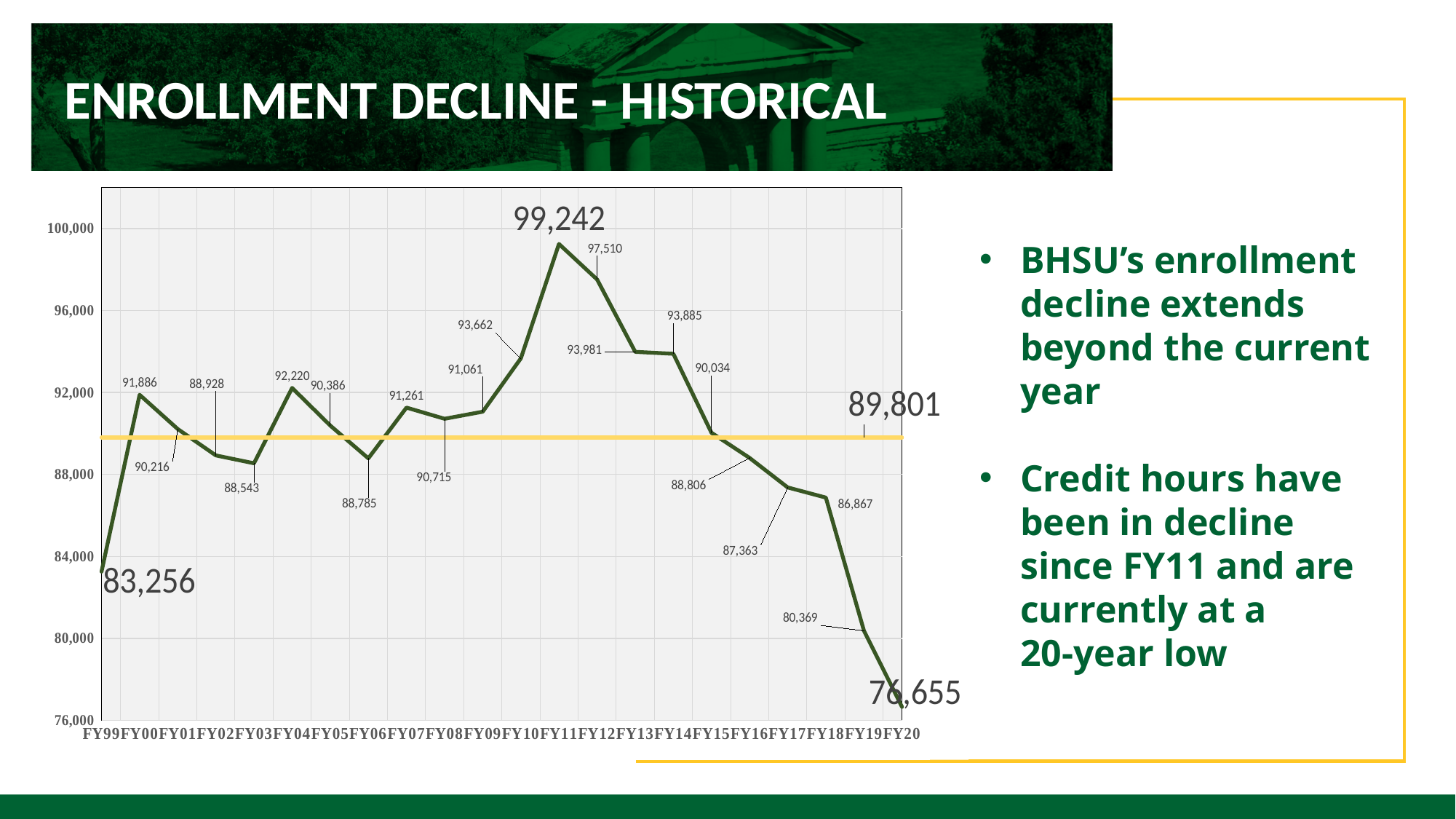
Is the value for FY99 greater or less than 84,000? less What is the difference between the FY11 value and the FY20 value? 22,587 What kind of chart is shown on the slide? line chart What is the value for FY20? 76,655 Do the values rise or fall from FY11 to FY20? fall What is the value for FY99? 83,256 What is the value for FY14? 93,885 Which fiscal year has the lowest value? FY20 How many fiscal years are plotted on the x axis? 22 Which is larger, the value for FY00 or the value for FY04? FY04 Which fiscal year has the highest value? FY11 What is the value for FY11? 99,242